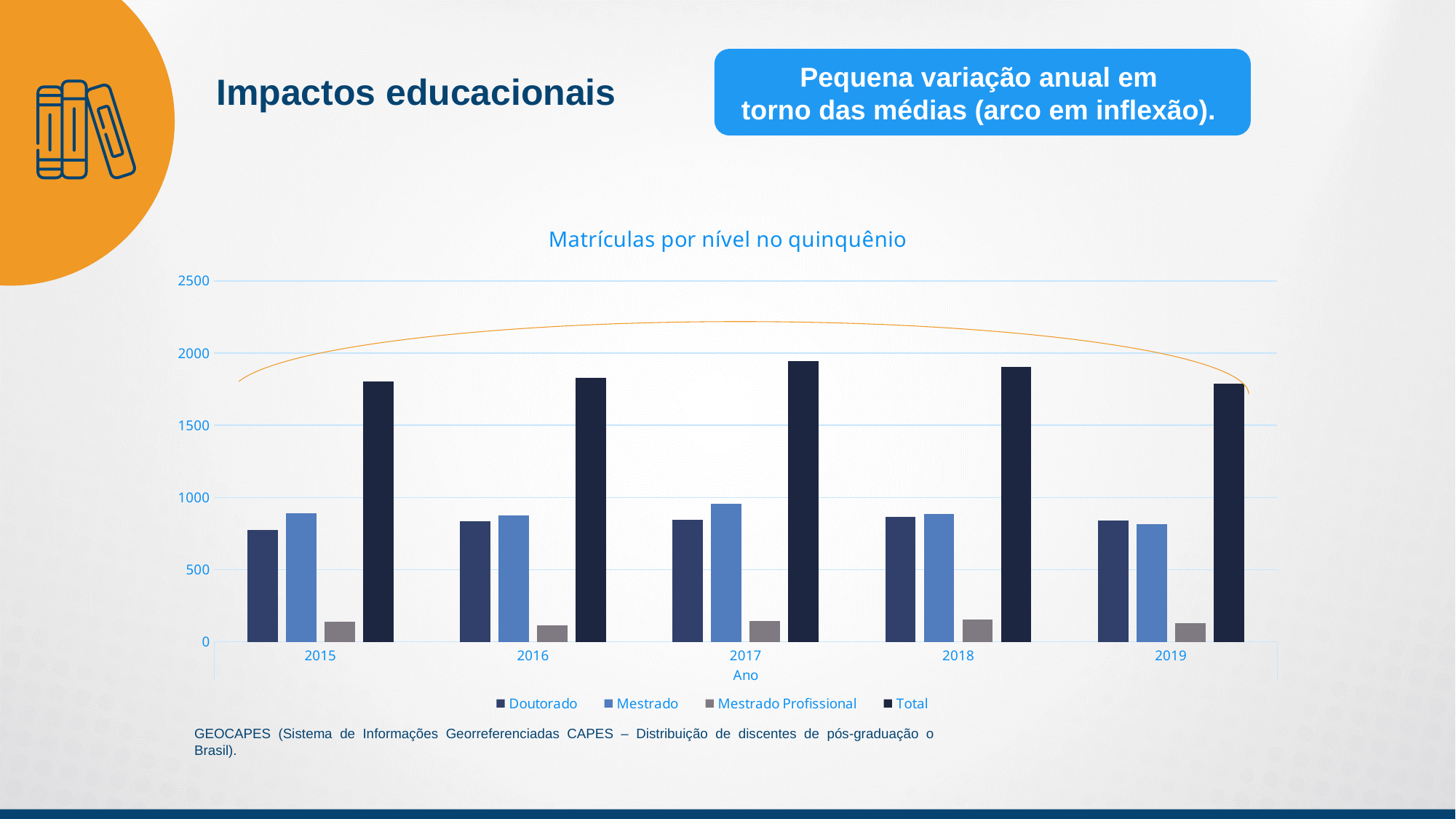
In which year is the Total bar the highest? 2017 How many years are shown on the x axis of the chart? 5 What is the title of the chart? Matrículas por nível no quinquênio In 2015, which is larger, Doutorado or Mestrado? Mestrado Is the value for Total in 2017 greater or less than 1500? greater In which year is the Doutorado bar the lowest? 2015 In which year is the Mestrado bar the highest? 2017 Is the value for Mestrado Profissional in 2018 greater or less than 500? less What is the label of the x axis? Ano What kind of chart is shown on the slide? bar chart Is the value for Doutorado in 2015 greater or less than 1000? less How many series does the chart legend list? 4